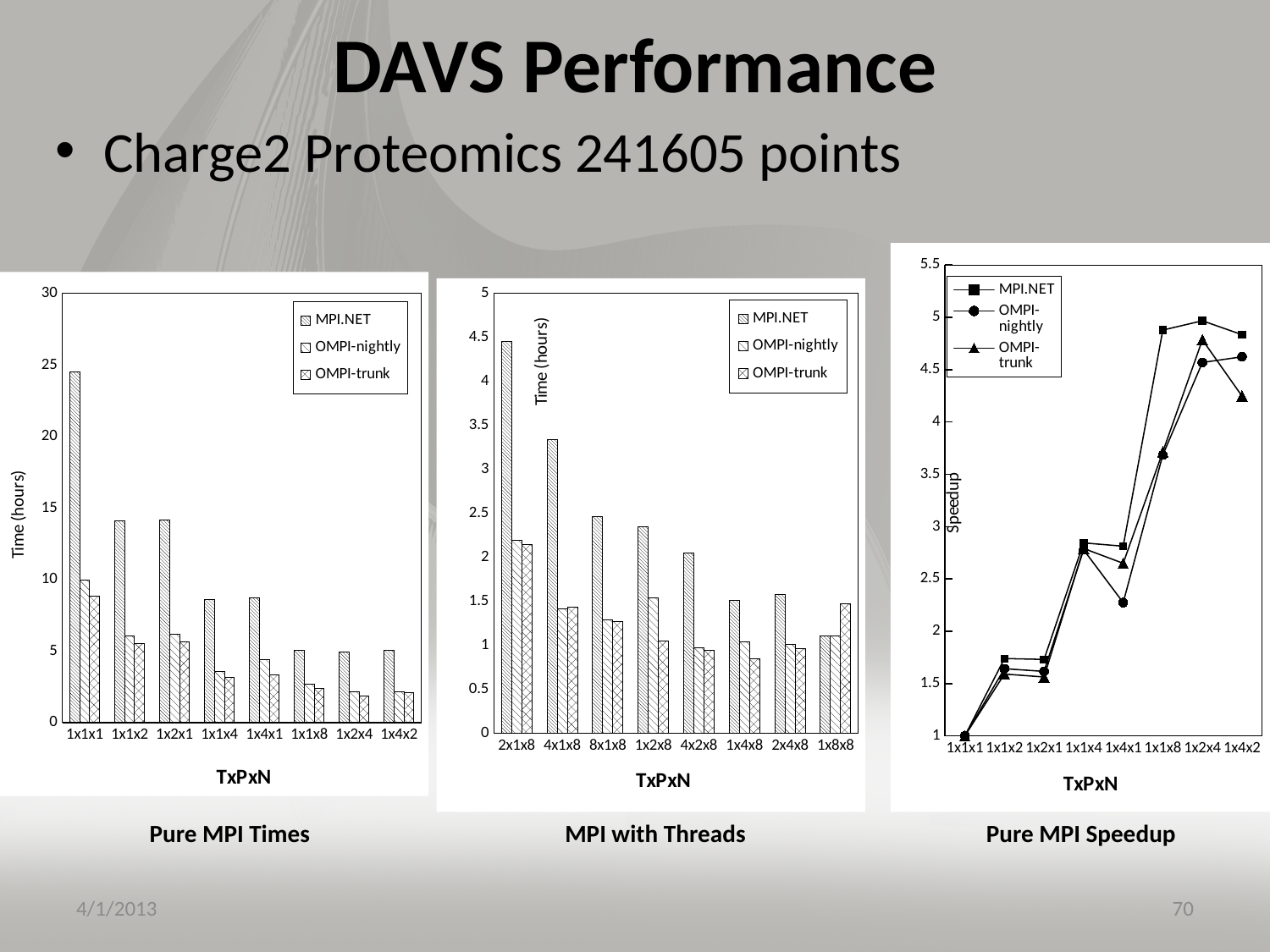
In the Pure MPI Times chart, is the MPI.NET time for 1x1x1 greater or less than 20? greater What kind of chart is the Pure MPI Speedup chart? line chart How many TxPxN categories are shown on the x axis of the MPI with Threads chart? 8 In the Pure MPI Times chart, which TxPxN category has the highest MPI.NET time? 1x1x1 In the Pure MPI Speedup chart, is the MPI.NET speedup at 1x2x4 greater or less than 4.5? greater In the MPI with Threads chart, which is larger: the MPI.NET time for 2x1x8 or for 4x1x8? 2x1x8 What kind of chart is the Pure MPI Times chart? bar chart In the MPI with Threads chart, which TxPxN category has the highest MPI.NET time? 2x1x8 In the Pure MPI Speedup chart, what is the MPI.NET speedup at 1x1x1? 1 In the Pure MPI Speedup chart, does the MPI.NET speedup generally rise or fall from 1x1x1 to 1x2x4? rise How many series does the legend of the Pure MPI Times chart list? 3 In the MPI with Threads chart, is the MPI.NET time for 2x1x8 greater or less than 4? greater